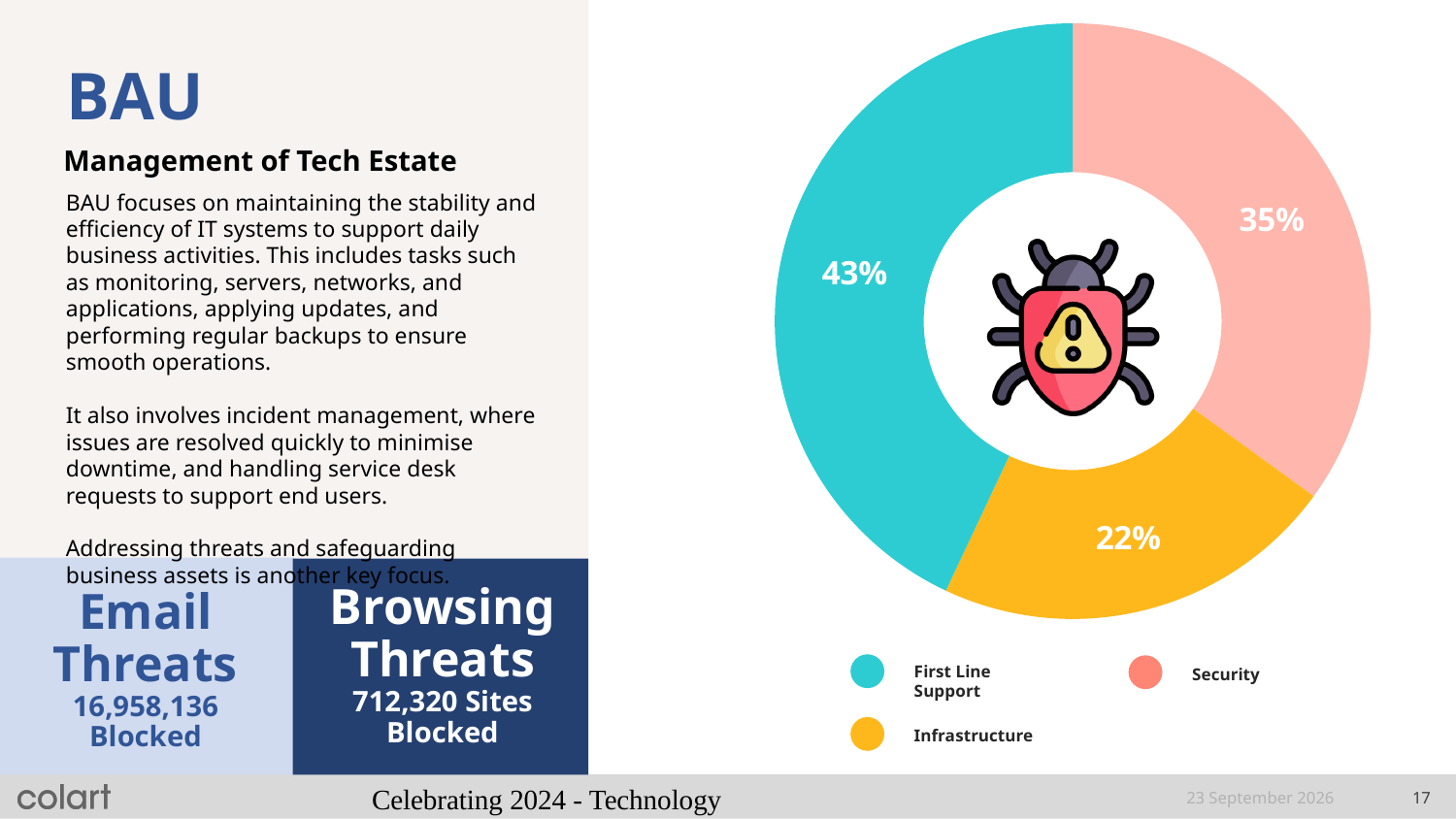
What is the difference in percentage points between First Line Support and Security? 8 What is the difference in percentage points between Security and Infrastructure? 13 What colour represents Infrastructure in the chart? Yellow/orange What kind of chart is shown on the slide? Donut (pie) chart What share of the donut chart does Security represent? 35% How many categories are shown in the donut chart? 3 Which category has the largest share of the donut chart? First Line Support Which category has the smallest share of the donut chart? Infrastructure What colour represents First Line Support in the chart? Teal Which is larger, the share for Security or the share for Infrastructure? Security What share of the donut chart does First Line Support represent? 43% What share of the donut chart does Infrastructure represent? 22%